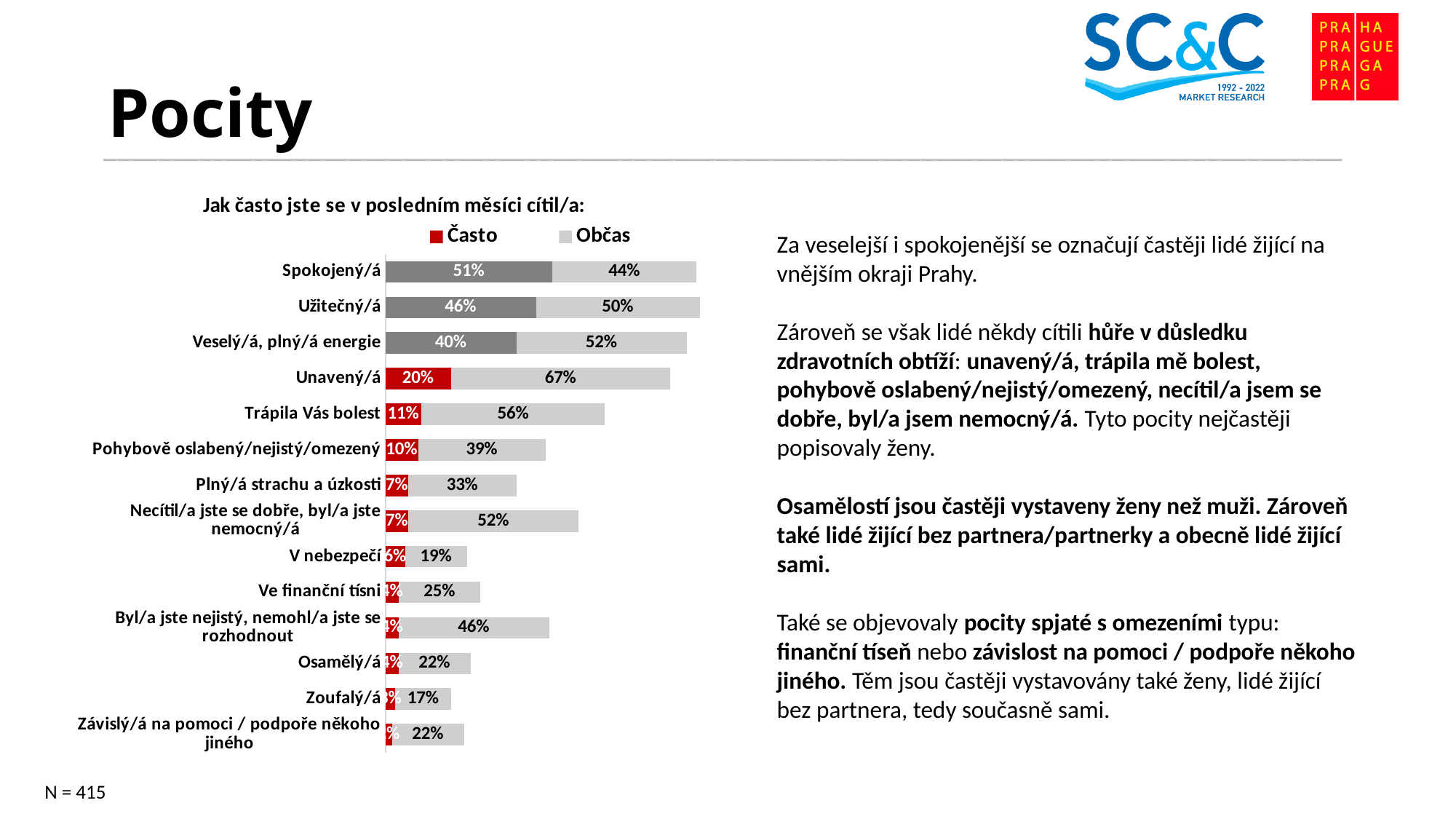
How many series does the chart legend list? 2 Which is larger: the 'Často' value for 'Užitečný/á' or for 'Veselý/á, plný/á energie'? Užitečný/á Which category has the highest 'Často' value? Spokojený/á What is the difference between the 'Občas' values for 'Unavený/á' and 'Trápila Vás bolest'? 11% What is the 'Občas' value for 'Unavený/á'? 67% Which category has the highest 'Občas' value? Unavený/á What is the 'Často' value for 'Spokojený/á'? 51% How many categories (feelings) are plotted in the chart? 14 What is the 'Často' value for 'Trápila Vás bolest'? 11% What is the total of the stacked bar for 'Spokojený/á'? 95% What is the title of the chart? Jak často jste se v posledním měsíci cítil/a: What kind of chart is shown on the slide? stacked bar chart